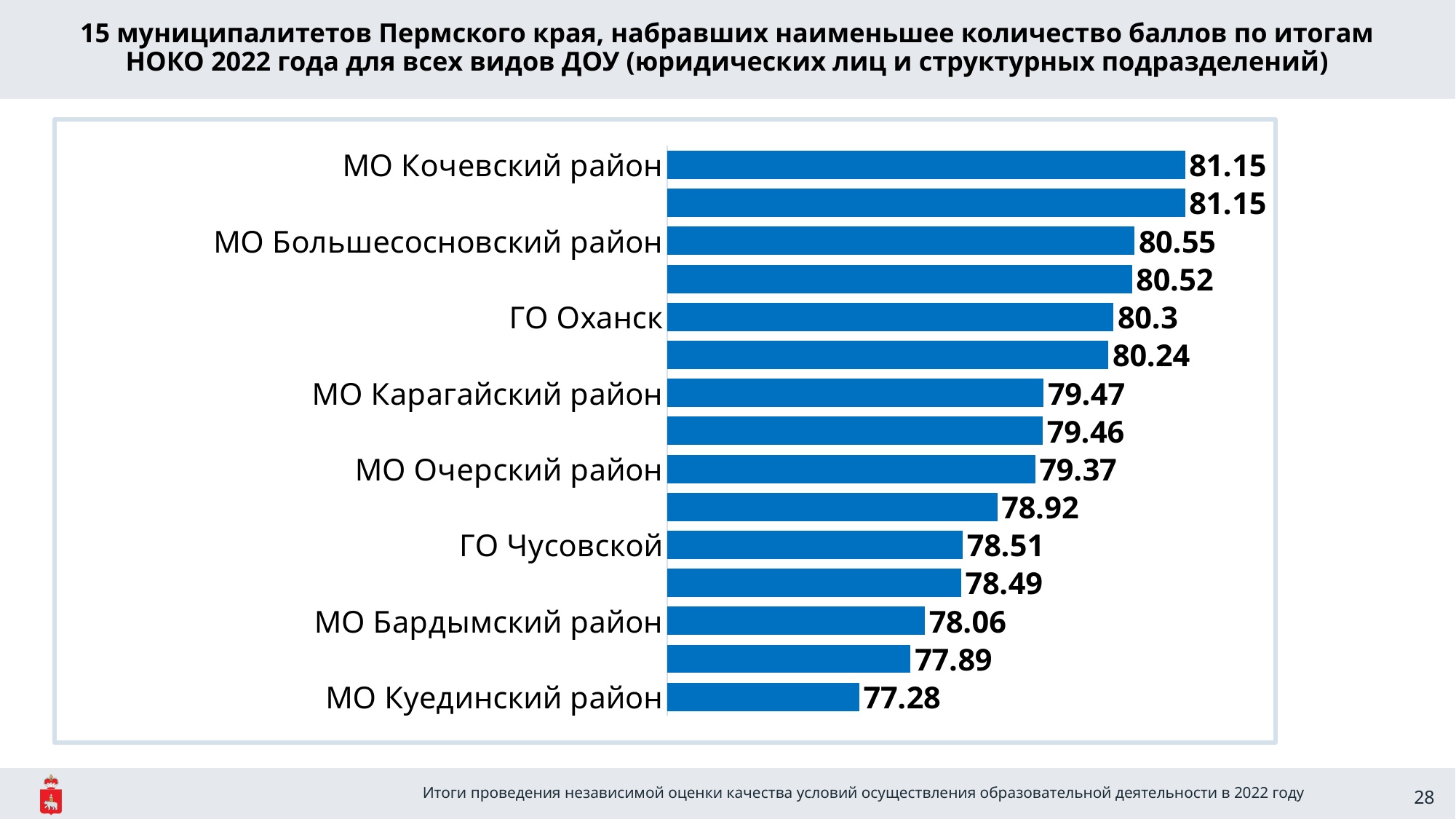
How many bars are plotted in the chart? 15 What is the value for МО Куединский район? 77.28 What is the value for МО Большесосновский район? 80.55 What is the value for ГО Оханск? 80.3 What is the value for ГО Чусовской? 78.51 Which has a larger value, МО Очерский район or МО Бардымский район? МО Очерский район What is the value for МО Карагайский район? 79.47 Which category has the lowest value in the chart? МО Куединский район What type of chart is shown on the slide? bar chart What is the value for МО Кочевский район? 81.15 What is the difference between the values for МО Кочевский район and МО Куединский район? 3.87 What is the highest value shown in the chart? 81.15